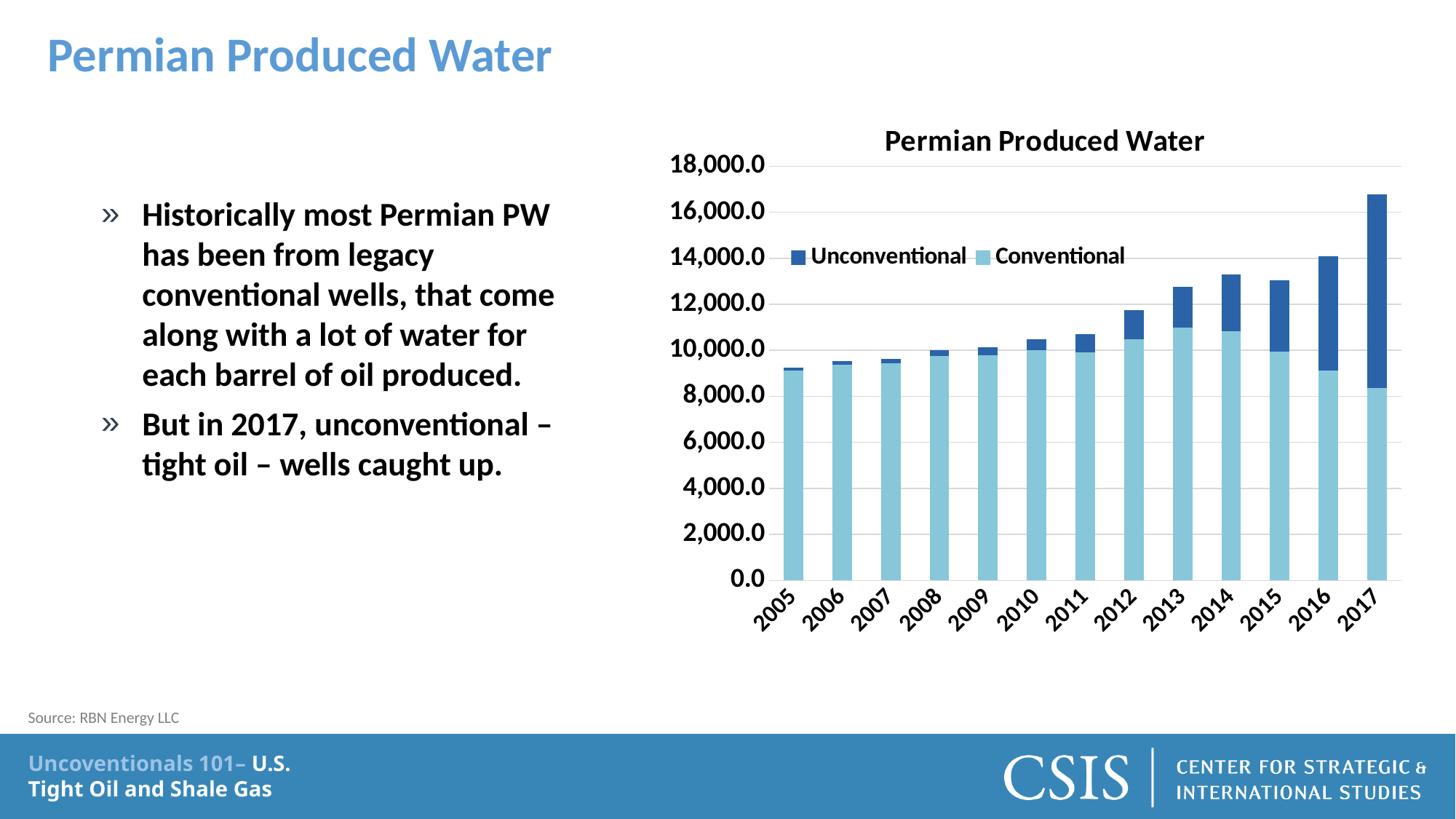
Is the total produced water for 2014 greater or less than 12,000.0? greater What kind of chart is shown on the slide? Stacked bar chart Which year has the lowest total produced water in the chart? 2005 What is the title of the chart on the slide? Permian Produced Water How many series does the legend of the Permian Produced Water chart list? 2 Does the total produced water generally rise or fall from 2005 to 2017? rise Which series is shown in dark blue in the chart? Unconventional How many years are shown on the x axis of the Permian Produced Water chart? 13 Is the total produced water for 2005 greater or less than 10,000.0? less Which year has the highest total produced water in the chart? 2017 Is the Conventional value for 2016 greater or less than 10,000.0? less